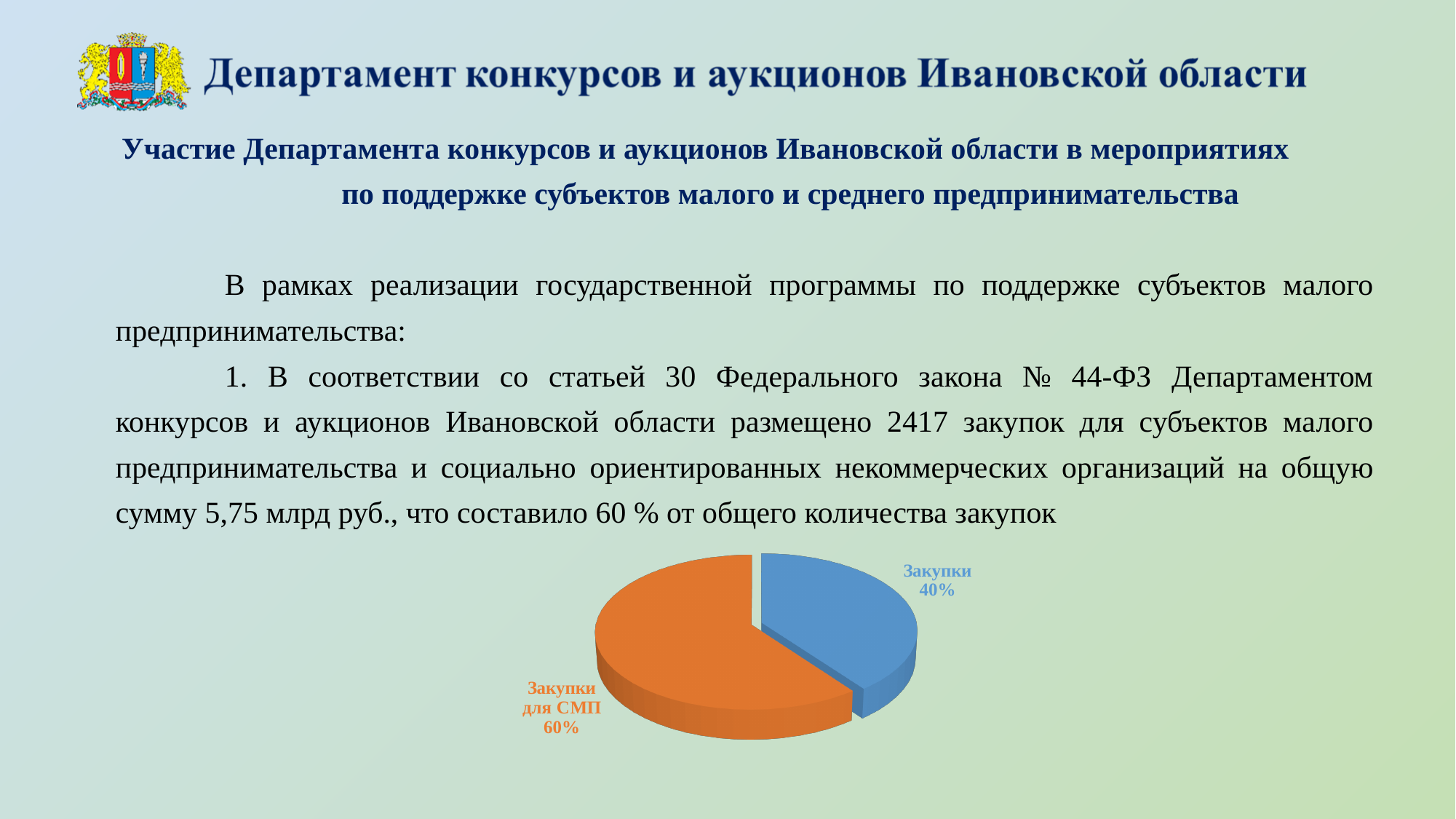
Which slice of the pie is the smallest? Закупки What share of the pie does "Закупки для СМП" represent? 60% Which is larger: the "Закупки" slice or the "Закупки для СМП" slice? Закупки для СМП What is the difference in percentage points between the "Закупки для СМП" slice and the "Закупки" slice? 20% What colour is the "Закупки" slice? Blue Which slice of the pie is the largest? Закупки для СМП What share of the pie does "Закупки" represent? 40% How many slices does the pie chart have? 2 What kind of chart is shown on the slide? Pie chart What colour is the "Закупки для СМП" slice? Orange